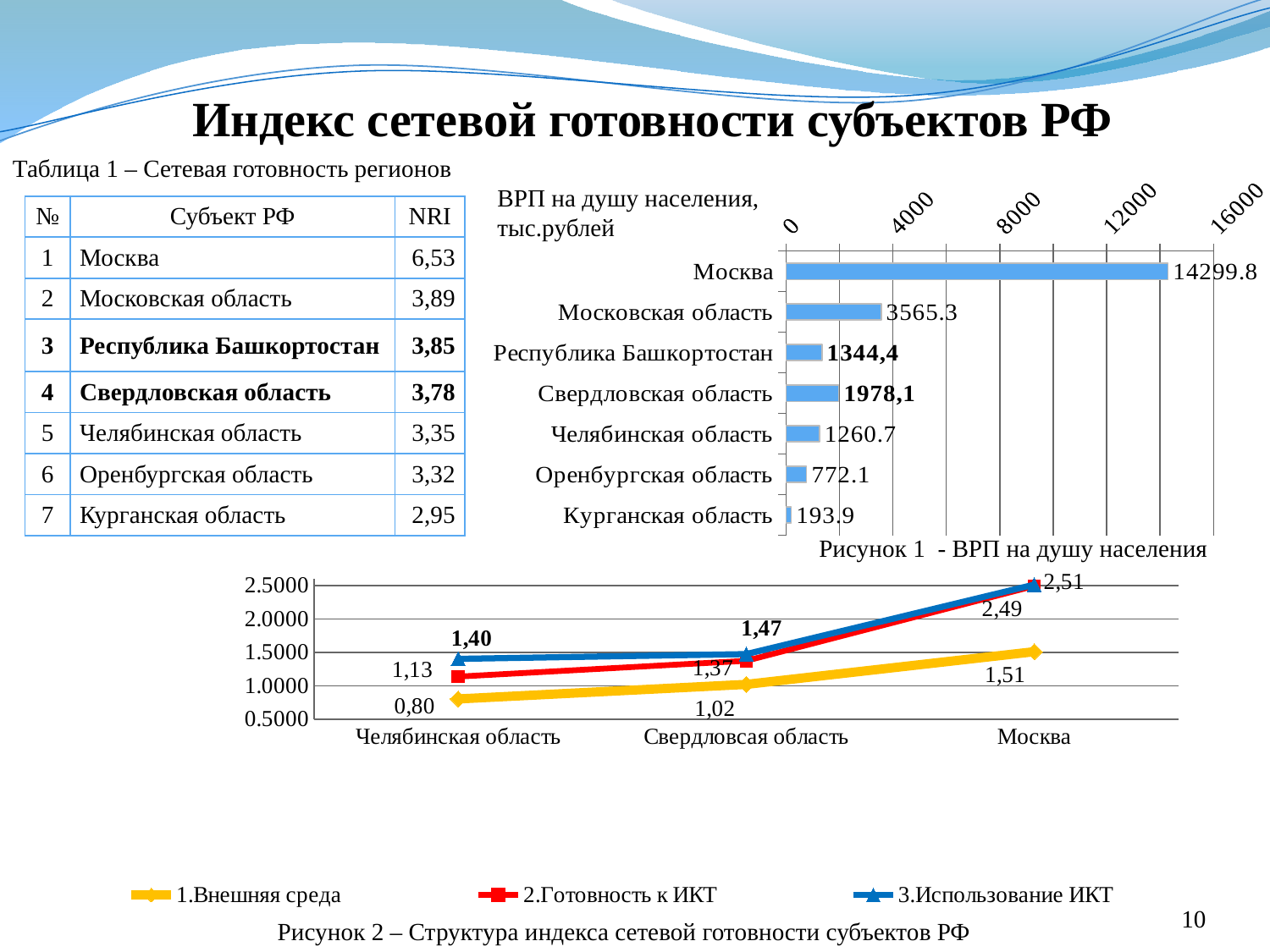
In the chart 'Рисунок 2 – Структура индекса сетевой готовности субъектов РФ', what is the value of 3.Использование ИКТ for Челябинская область? 1,40 In the chart 'Рисунок 1 - ВРП на душу населения', which is larger, the value for Челябинская область or Оренбургская область? Челябинская область In the chart 'Рисунок 1 - ВРП на душу населения', what is the value for Москва? 14299.8 In the chart 'Рисунок 1 - ВРП на душу населения', what is the value for Свердловская область? 1978,1 In the chart 'Рисунок 1 - ВРП на душу населения', which region has the highest value? Москва In the chart 'Рисунок 2 – Структура индекса сетевой готовности субъектов РФ', what is the value of 1.Внешняя среда for Москва? 1,51 What kind of chart is 'Рисунок 2 – Структура индекса сетевой готовности субъектов РФ'? Line chart In the chart 'Рисунок 2 – Структура индекса сетевой готовности субъектов РФ', how many series does the legend list? 3 What kind of chart is 'Рисунок 1 - ВРП на душу населения'? Bar chart In the chart 'Рисунок 1 - ВРП на душу населения', which region has the lowest value? Курганская область In the chart 'Рисунок 2 – Структура индекса сетевой готовности субъектов РФ', does the 1.Внешняя среда series rise or fall from Челябинская область to Москва? Rise In the chart 'Рисунок 1 - ВРП на душу населения', how many regions are shown? 7